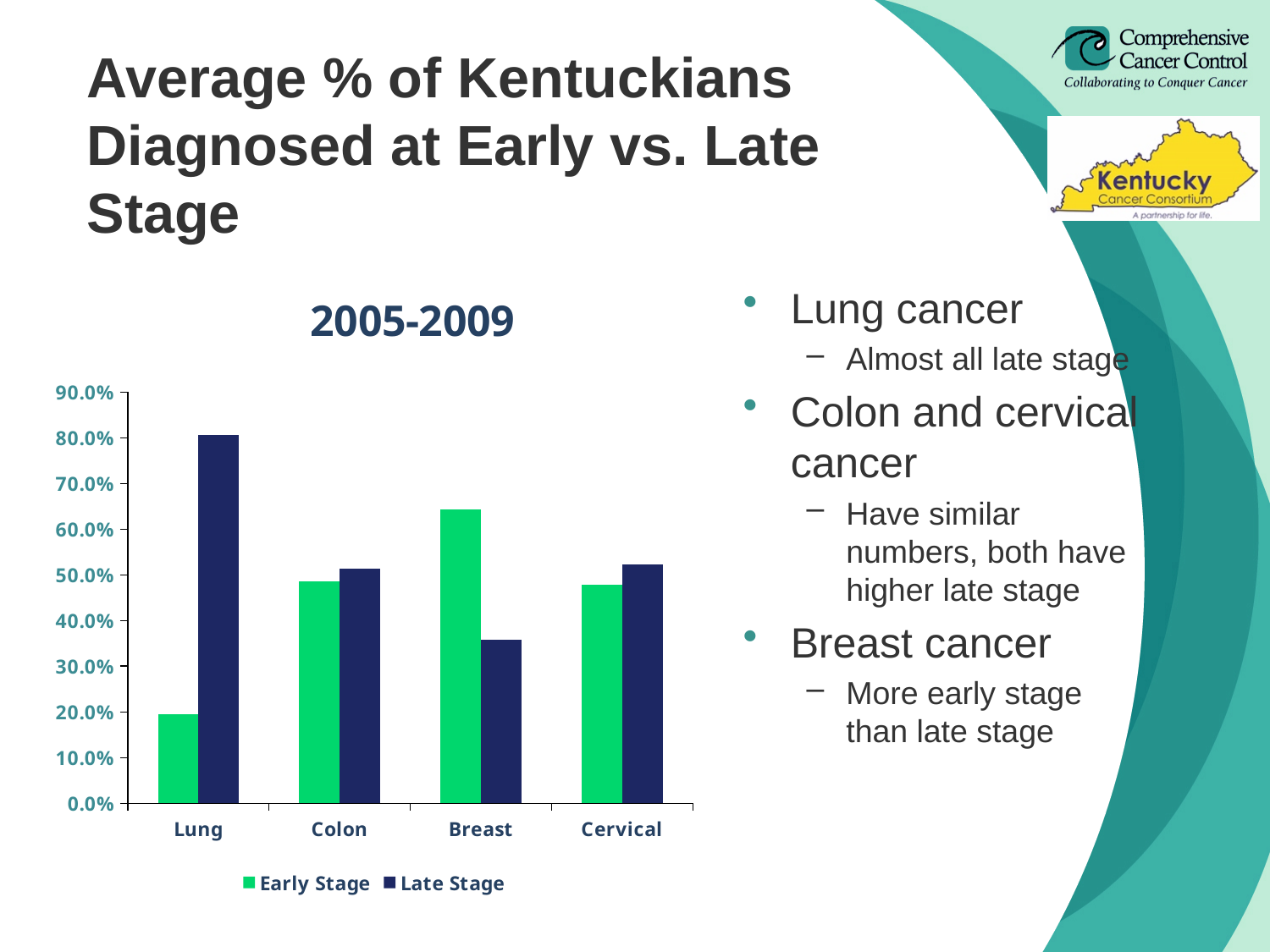
Which cancer type has the lowest Early Stage bar? Lung How many series does the chart legend list? 2 Which cancer type has the highest Late Stage bar? Lung What is the title shown above the chart? 2005-2009 For Breast cancer, which is larger: the Early Stage or the Late Stage value? Early Stage Is the Late Stage value for Lung greater or less than 70.0%? greater What type of chart is shown on the slide? Bar chart For Lung cancer, which is larger: the Early Stage or the Late Stage value? Late Stage Which cancer type has the lowest Late Stage bar? Breast Is the Late Stage value for Breast greater or less than 40.0%? less How many cancer types are shown on the x axis of the chart? 4 Which cancer type has the highest Early Stage bar? Breast